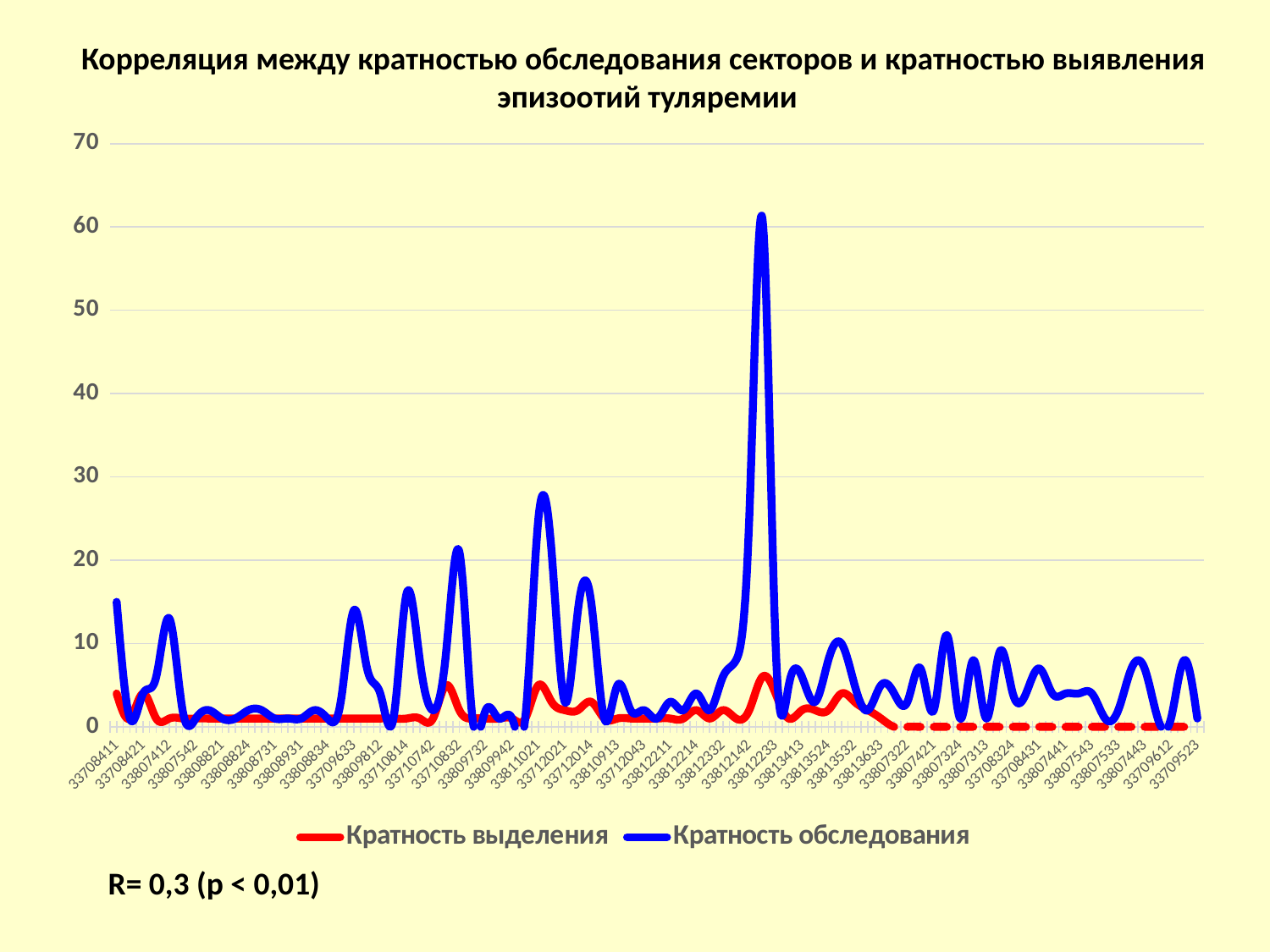
Which series reaches the highest value on the chart? Кратность обследования Is the value of Кратность обследования at 33811021 greater or less than 20? greater Is the value of Кратность обследования at 33708411 greater or less than 10? greater Which series is drawn in blue? Кратность обследования Which series is drawn in red? Кратность выделения Is the value of Кратность выделения at 33812233 greater or less than 10? less At 33812233, which series has the larger value, Кратность выделения or Кратность обследования? Кратность обследования What kind of chart is shown on the slide? Line chart How many series does the legend list? 2